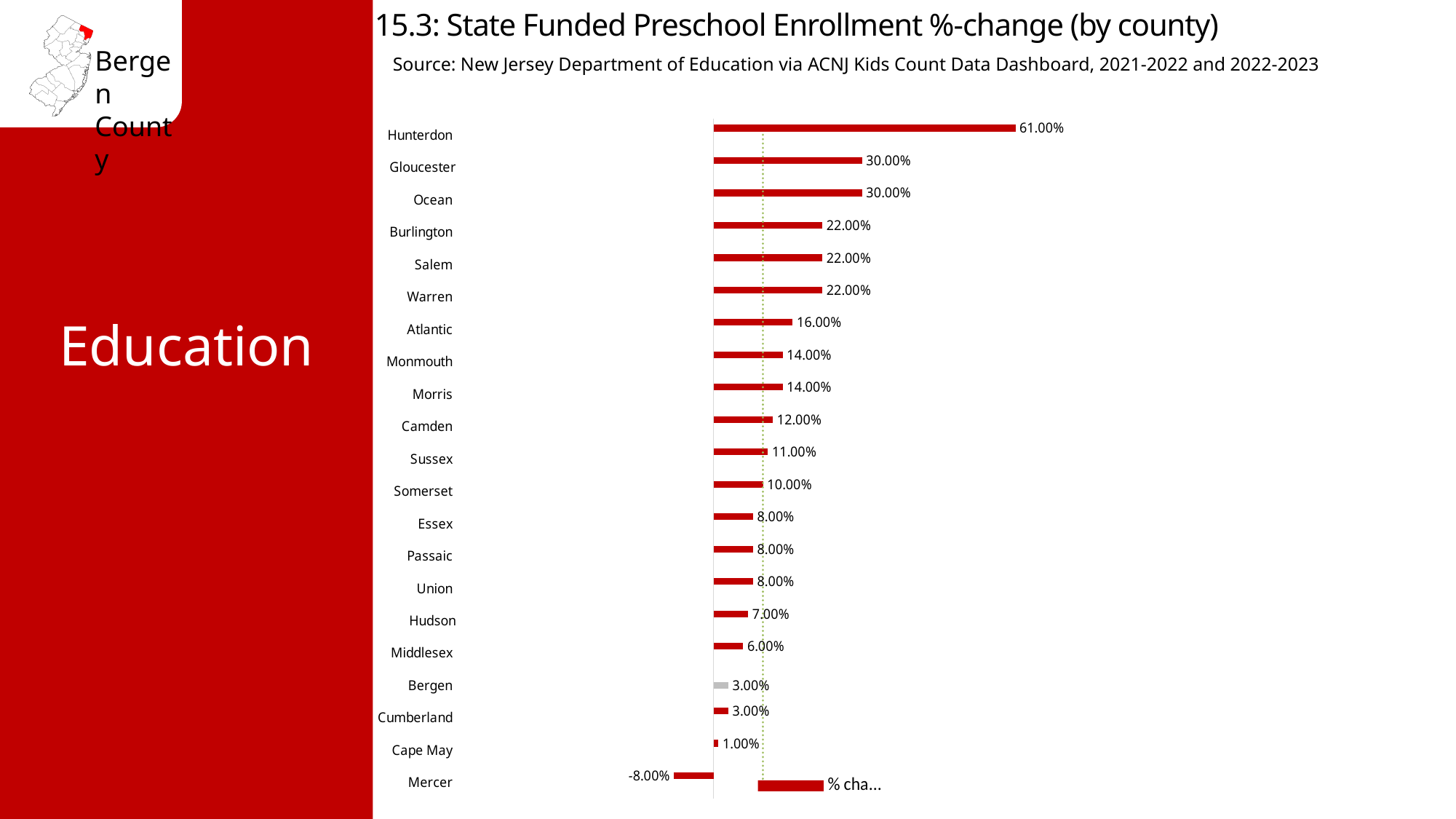
Which county's bar is coloured grey instead of red? Bergen What is the value shown for Mercer? -8.00% How many counties are shown in the chart? 21 What is the difference between the values for Burlington and Camden? 10.00% Which is larger, the value for Ocean or the value for Warren? Ocean Which county has the lowest %-change? Mercer What is the state funded preschool enrollment %-change for Hunterdon? 61.00% Which county has the highest %-change? Hunterdon What is the value shown for Bergen? 3.00% What is the value shown for Atlantic? 16.00% What is the difference between the values for Hunterdon and Gloucester? 31.00% What kind of chart is shown on the slide? Bar chart